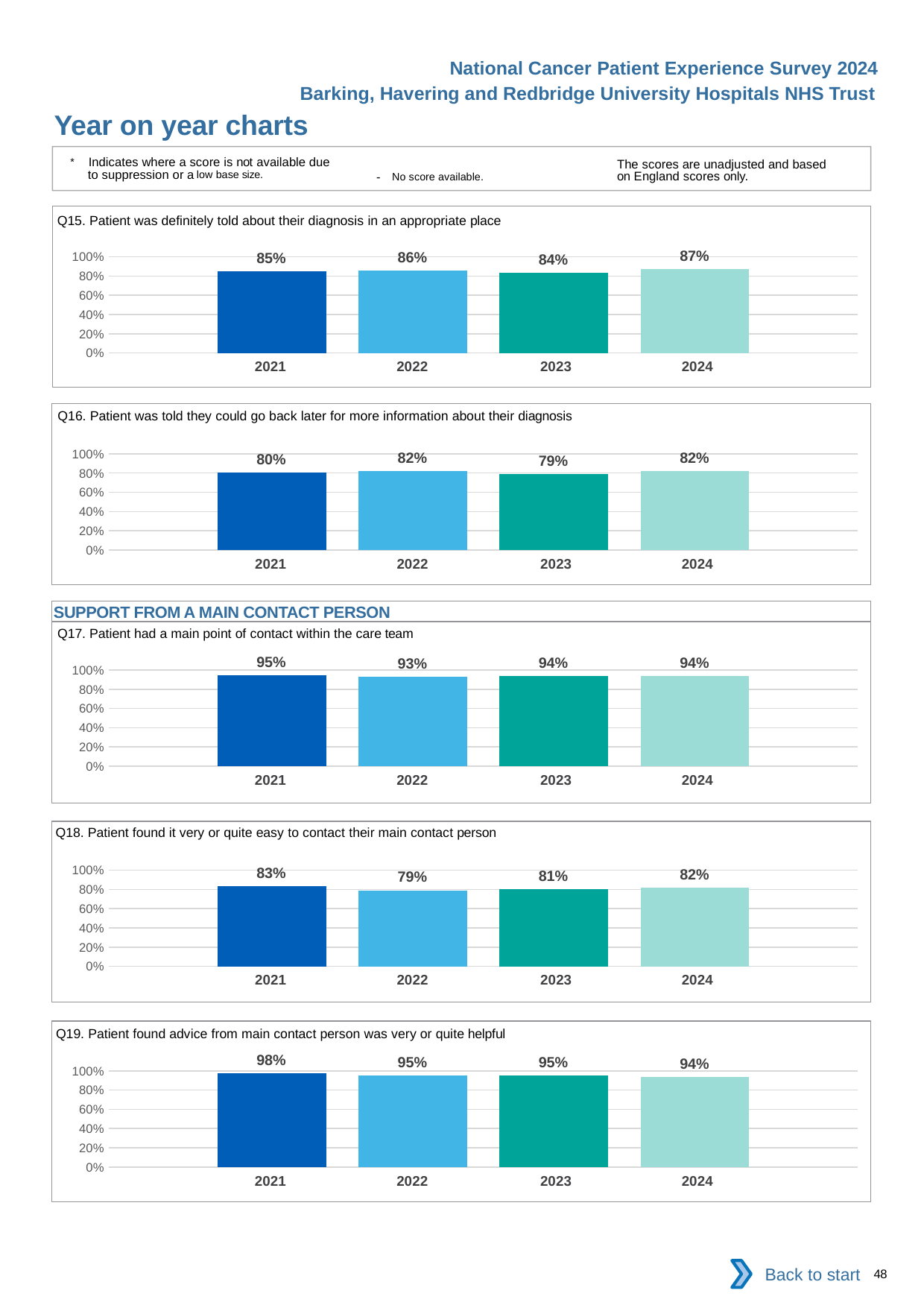
In the Q17 chart, what is the value for 2022? 93% In the Q18 chart (patient found it very or quite easy to contact their main contact person), which is larger, the value for 2021 or the value for 2022? 2021 In the Q16 chart, what is the difference between the 2022 and 2023 values? 3% How many years are shown on the x axis of the Q19 chart? 4 What type of chart is the Q15 chart? Bar chart In the Q19 chart (patient found advice from main contact person was very or quite helpful), what is the value for 2021? 98% In the Q18 chart, what is the difference between the 2021 and 2022 values? 4% In the Q17 chart (patient had a main point of contact within the care team), which year has the highest value? 2021 In the Q19 chart, which year has the lowest value? 2024 In the Q15 chart (patient was definitely told about their diagnosis in an appropriate place), what is the value for 2024? 87% In the Q15 chart, which year has the lowest value? 2023 In the Q16 chart (patient was told they could go back later for more information about their diagnosis), what is the value for 2021? 80%